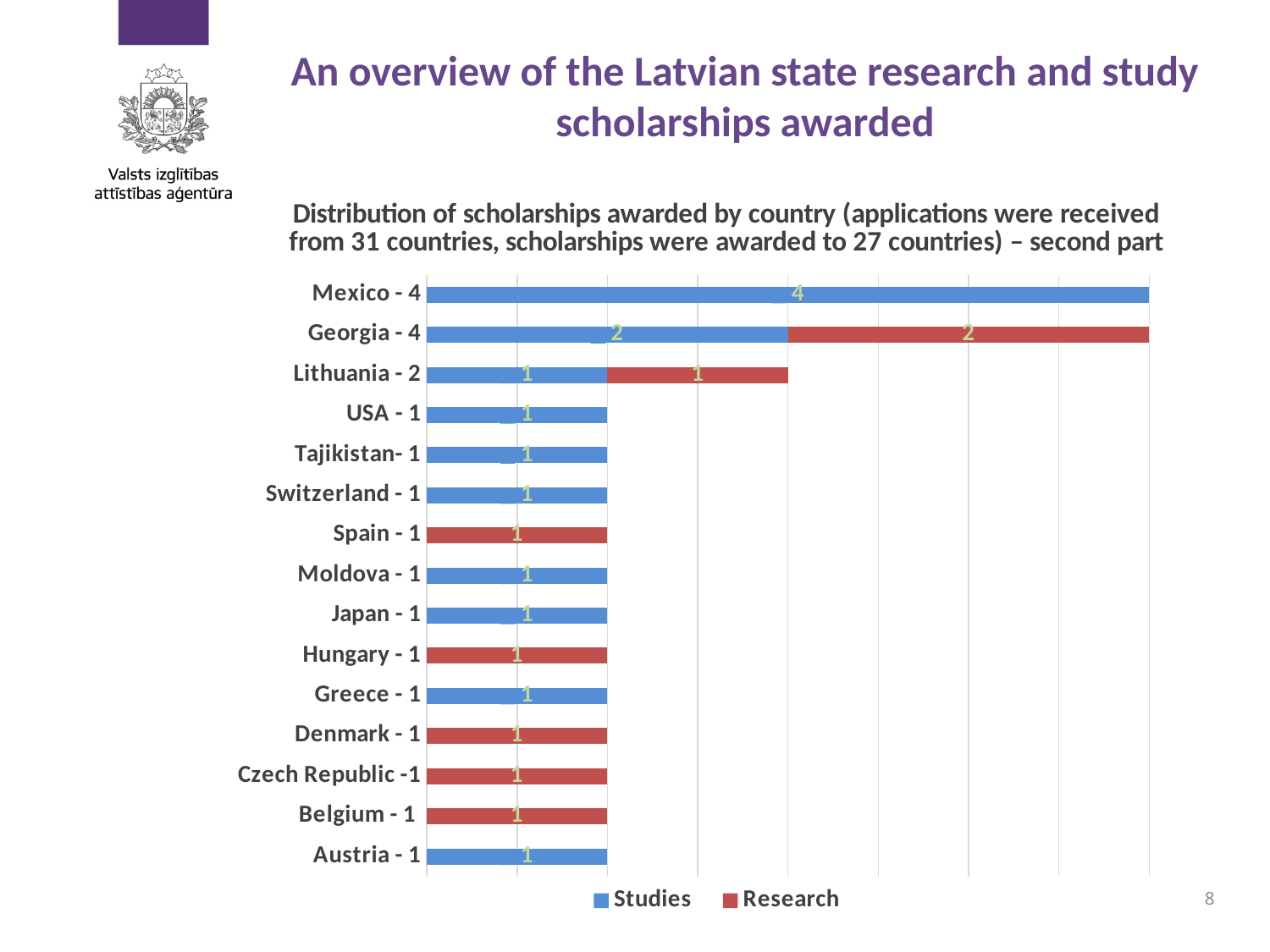
What is the total of the stacked bar for Georgia? 4 What is the Research value for Georgia? 2 How many series does the legend list? 2 What is the Studies value for Mexico? 4 Which is larger, the Studies value for Georgia or the Studies value for Lithuania? Georgia Which series is shown in red? Research What kind of chart is shown on the slide? Bar chart How many countries are shown on the chart? 15 What is the Studies value for Lithuania? 1 Which series does the Spain bar belong to? Research What is the difference between the Studies value for Mexico and the Studies value for Georgia? 2 What is the total of the stacked bar for Lithuania? 2